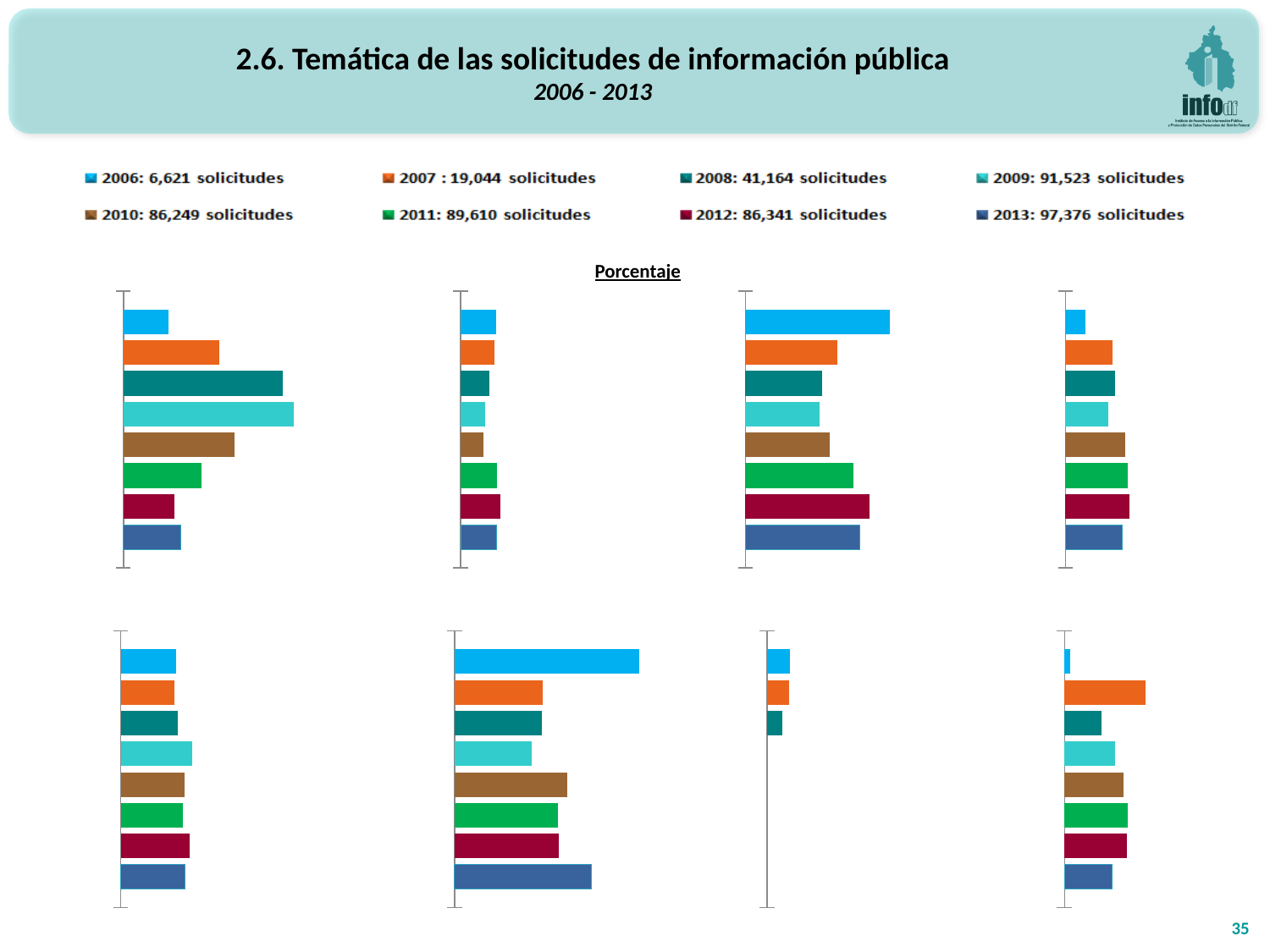
What kind of chart is the top-left chart? bar chart How many bars does the third chart in the bottom row have? 3 How many bars does the top-left chart have? 8 In the fourth chart of the bottom row, which year has the shortest bar? 2006 According to the legend, how many solicitudes were there in 2013? 97,376 solicitudes In the top-left chart, which bar is longer, 2008 or 2007? 2008 In the top-left chart, which year has the longest bar? 2009 How many series does the legend list? 8 In the fourth chart of the bottom row, which year has the longest bar? 2007 In the third chart of the top row, which year has the longest bar? 2006 In the top-left chart, which year has the shortest bar? 2006